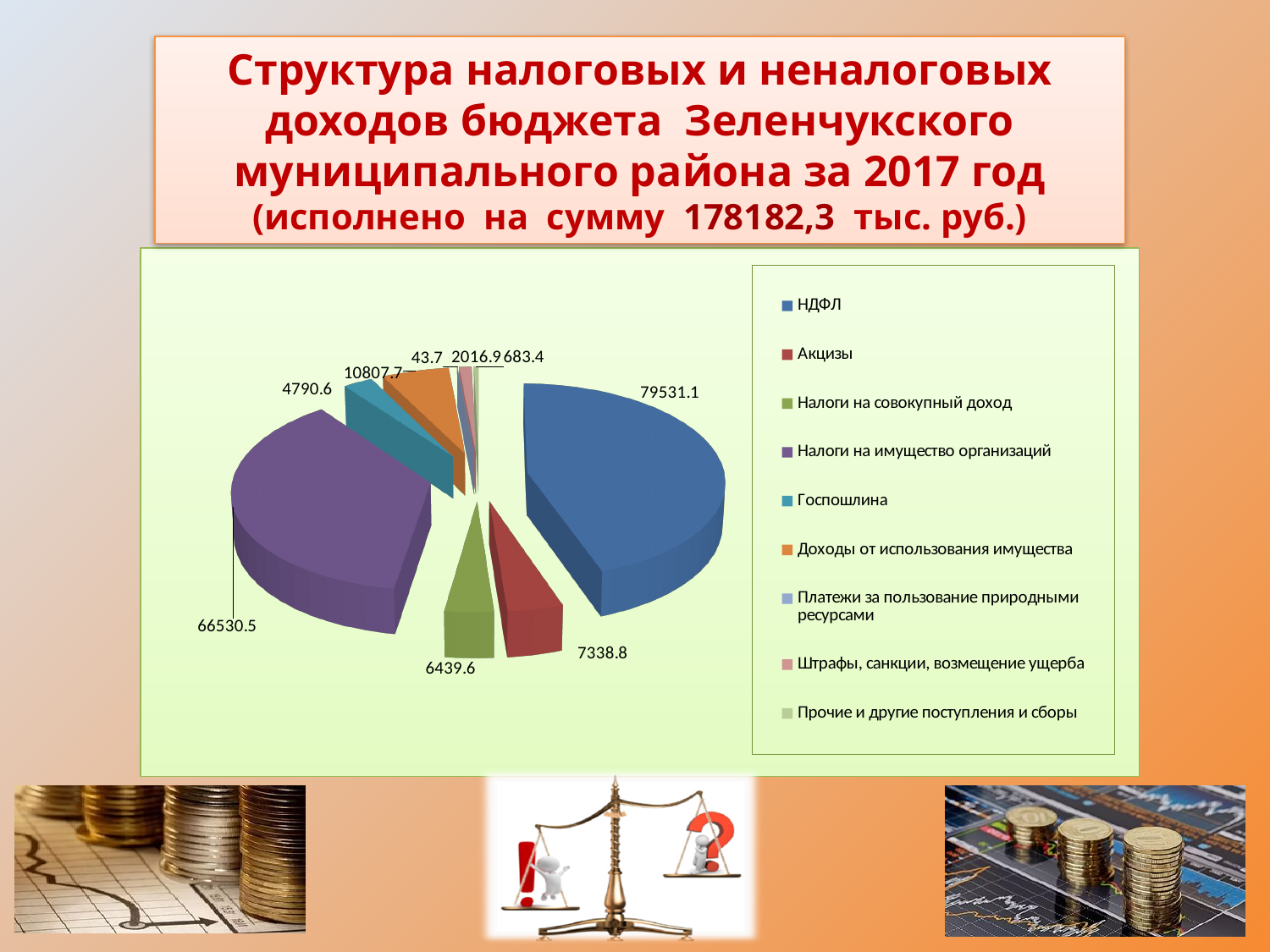
What value is shown for Налоги на имущество организаций? 66530.5 What type of chart is shown on the slide? Pie chart What is the difference between the values for Акцизы and Налоги на совокупный доход? 899.2 What value is shown for НДФЛ on the pie chart? 79531.1 What value is shown for Госпошлина? 4790.6 Which category has the largest slice of the pie chart? НДФЛ Which category has the smallest value on the pie chart? Платежи за пользование природными ресурсами How many categories does the legend of the pie chart list? 9 What value is shown for Доходы от использования имущества? 10807.7 Which is larger, Акцизы or Налоги на совокупный доход? Акцизы What colour is the slice for Налоги на имущество организаций? Purple What is the difference between the values for НДФЛ and Налоги на имущество организаций? 13000.6